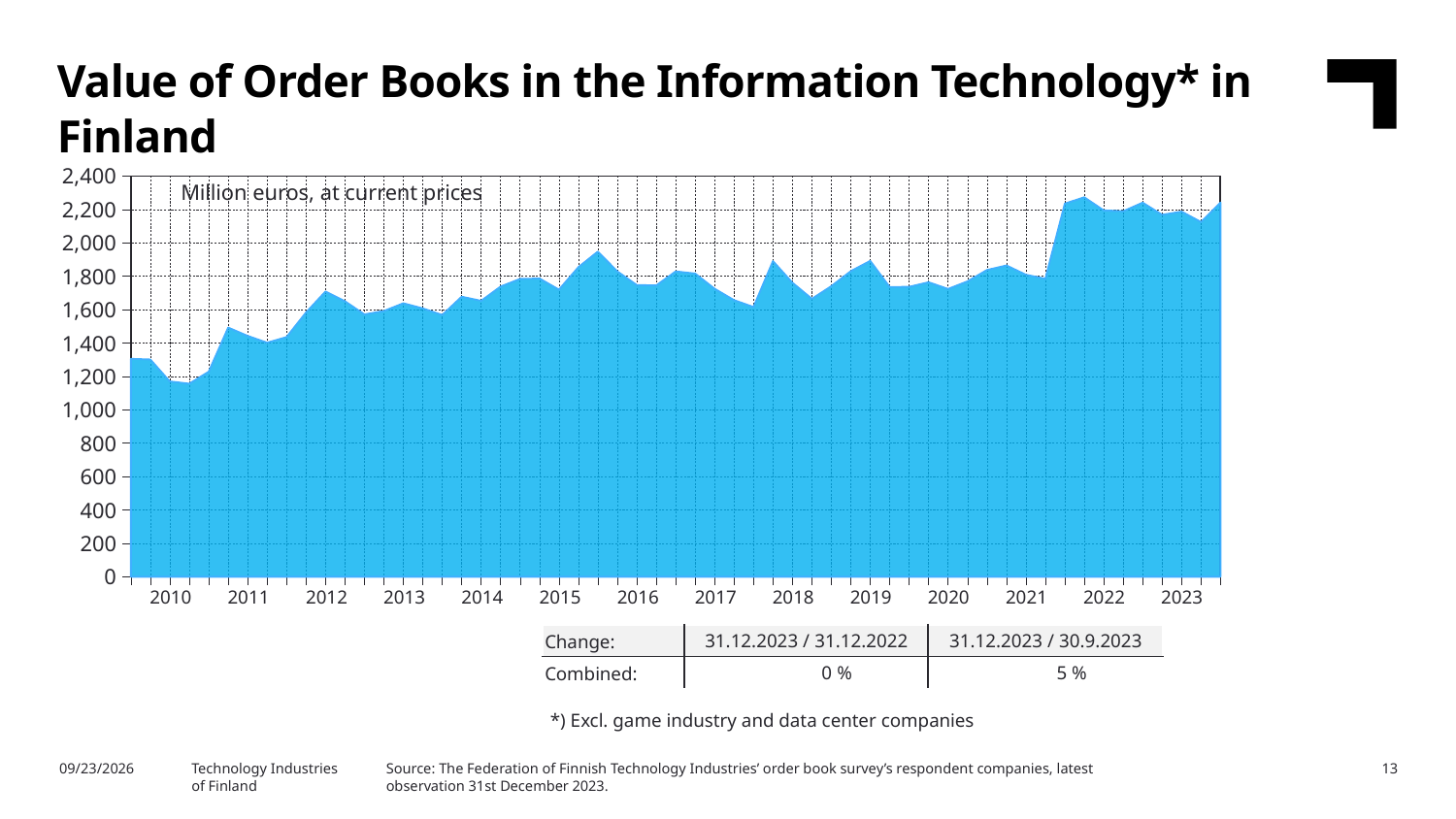
What kind of chart is shown on the slide? Area chart In which year does the chart reach its highest value? 2022 What is the title of the chart? Value of Order Books in the Information Technology* in Finland How many years are labelled on the x axis? 14 Is the highest value in 2022 greater or less than 2,200? greater In which year does the chart reach its lowest value? 2010 Is the lowest value in 2010 greater or less than 1,400? less Are the values during 2023 greater or less than 2,000? greater In what unit are the values on the chart expressed? Million euros, at current prices What is the combined change from 31.12.2022 to 31.12.2023 shown in the table below the chart? 0 % Overall, do the values rise or fall from 2010 to 2023? Rise